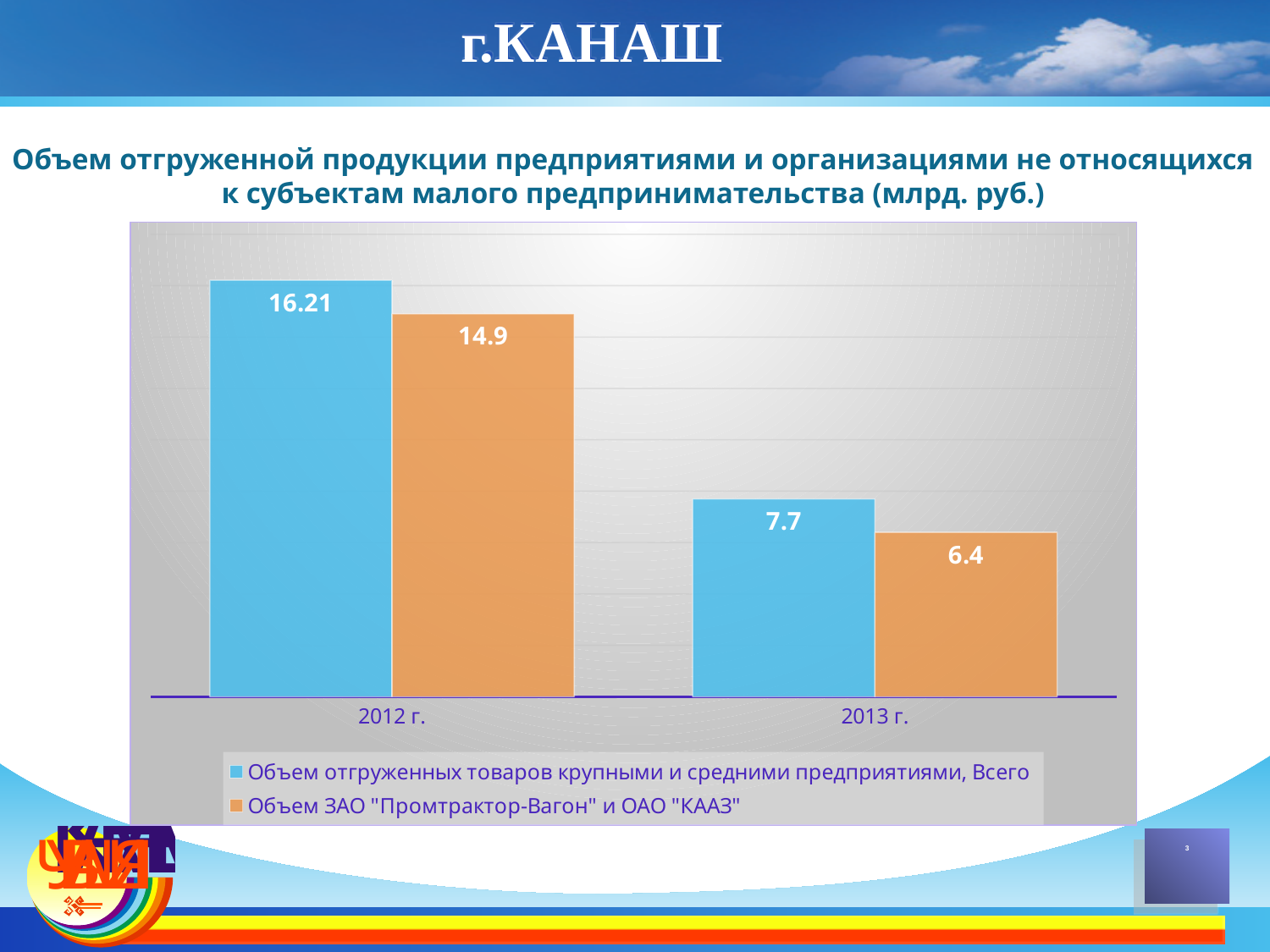
What is the value for 'Объем отгруженных товаров крупными и средними предприятиями, Всего' in 2012 г.? 16.21 How many series does the legend list? 2 How many year categories are shown on the x axis? 2 What is the difference between the two series' values in 2012 г.? 1.31 Which year has the highest value for 'Объем отгруженных товаров крупными и средними предприятиями, Всего'? 2012 г. What is the value for 'Объем отгруженных товаров крупными и средними предприятиями, Всего' in 2013 г.? 7.7 By how much did 'Объем отгруженных товаров крупными и средними предприятиями, Всего' fall from 2012 г. to 2013 г.? 8.51 Which bar on the chart has the lowest value? Объем ЗАО "Промтрактор-Вагон" и ОАО "КААЗ" in 2013 г. What kind of chart is shown on the slide? Bar chart What is the value for 'Объем ЗАО "Промтрактор-Вагон" и ОАО "КААЗ"' in 2012 г.? 14.9 Which is larger: the 2013 г. value for 'Объем отгруженных товаров крупными и средними предприятиями, Всего' or the 2013 г. value for 'Объем ЗАО "Промтрактор-Вагон" и ОАО "КААЗ"'? Объем отгруженных товаров крупными и средними предприятиями, Всего What is the value for 'Объем ЗАО "Промтрактор-Вагон" и ОАО "КААЗ"' in 2013 г.? 6.4